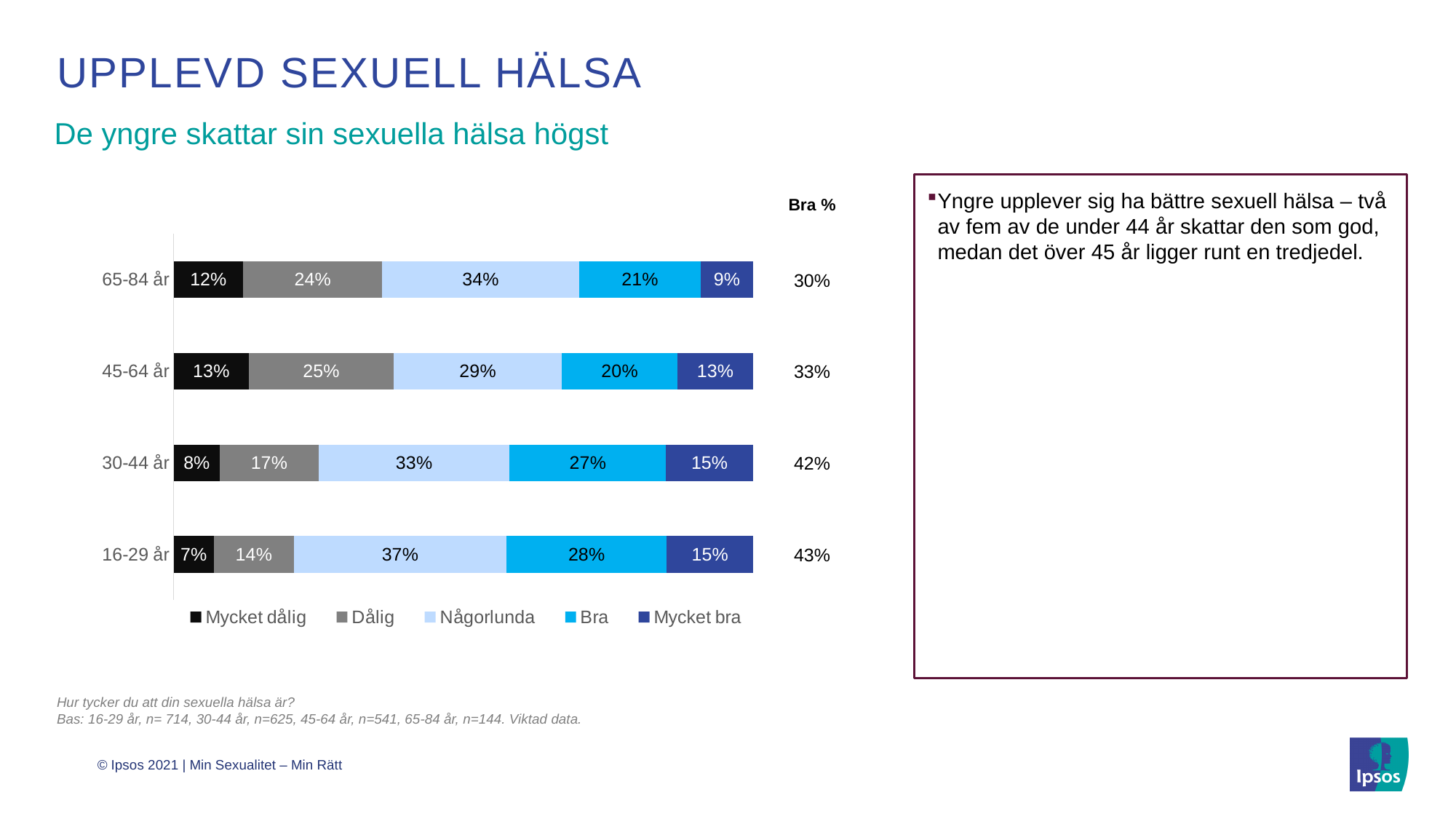
Which age group has the highest share answering "Någorlunda"? 16-29 år What is the "Bra %" value shown for the 16-29 år group? 43% What percentage of the 16-29 år group answered "Någorlunda"? 37% What is the total of the segments in the 65-84 år bar? 100% Which group has a larger "Dålig" share, 45-64 år or 30-44 år? 45-64 år How many age groups are shown in the chart? 4 How many series does the legend list? 5 What percentage of the 30-44 år group answered "Bra"? 27% What percentage of the 65-84 år group answered "Mycket dålig"? 12% How many percentage points higher is the "Bra" share for 16-29 år than for 65-84 år? 7 percentage points Which age group has the lowest share answering "Mycket bra"? 65-84 år What kind of chart is shown on the slide? Stacked bar chart